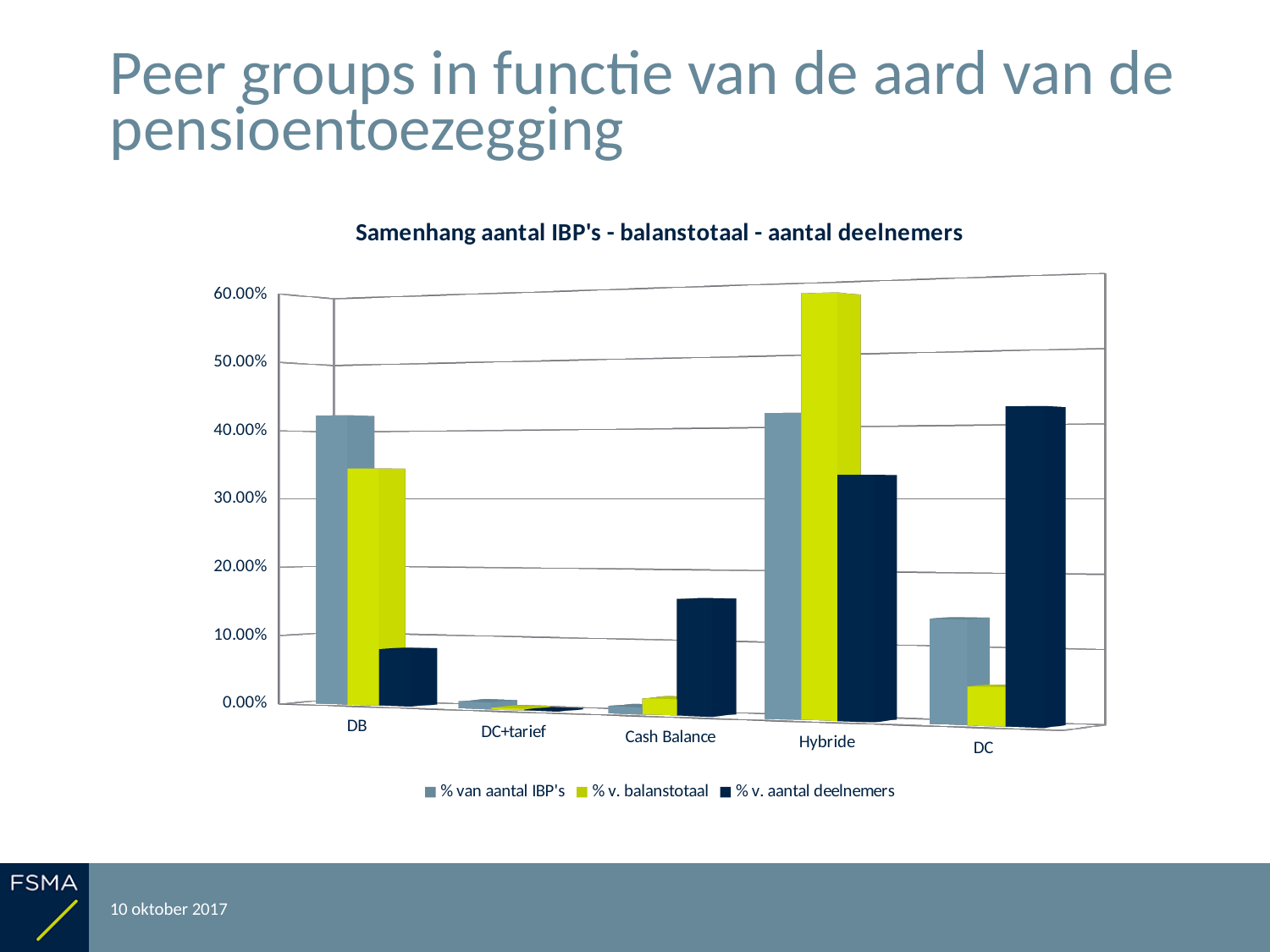
Which category has the highest value for % v. balanstotaal? Hybride Is the value for % v. aantal deelnemers for DB greater or less than 20.00%? less What is the title of the chart? Samenhang aantal IBP's - balanstotaal - aantal deelnemers Is the value for % van aantal IBP's for DC greater or less than 20.00%? less For % v. aantal deelnemers, which is larger: DB or Hybride? Hybride How many categories are shown on the x axis of the chart? 5 What kind of chart is shown on the slide? bar chart How many series does the legend list? 3 Is the value for % v. balanstotaal for Hybride greater or less than 50.00%? greater Which category has the highest value for % v. aantal deelnemers? DC Which category has the lowest value for % v. aantal deelnemers? DC+tarief